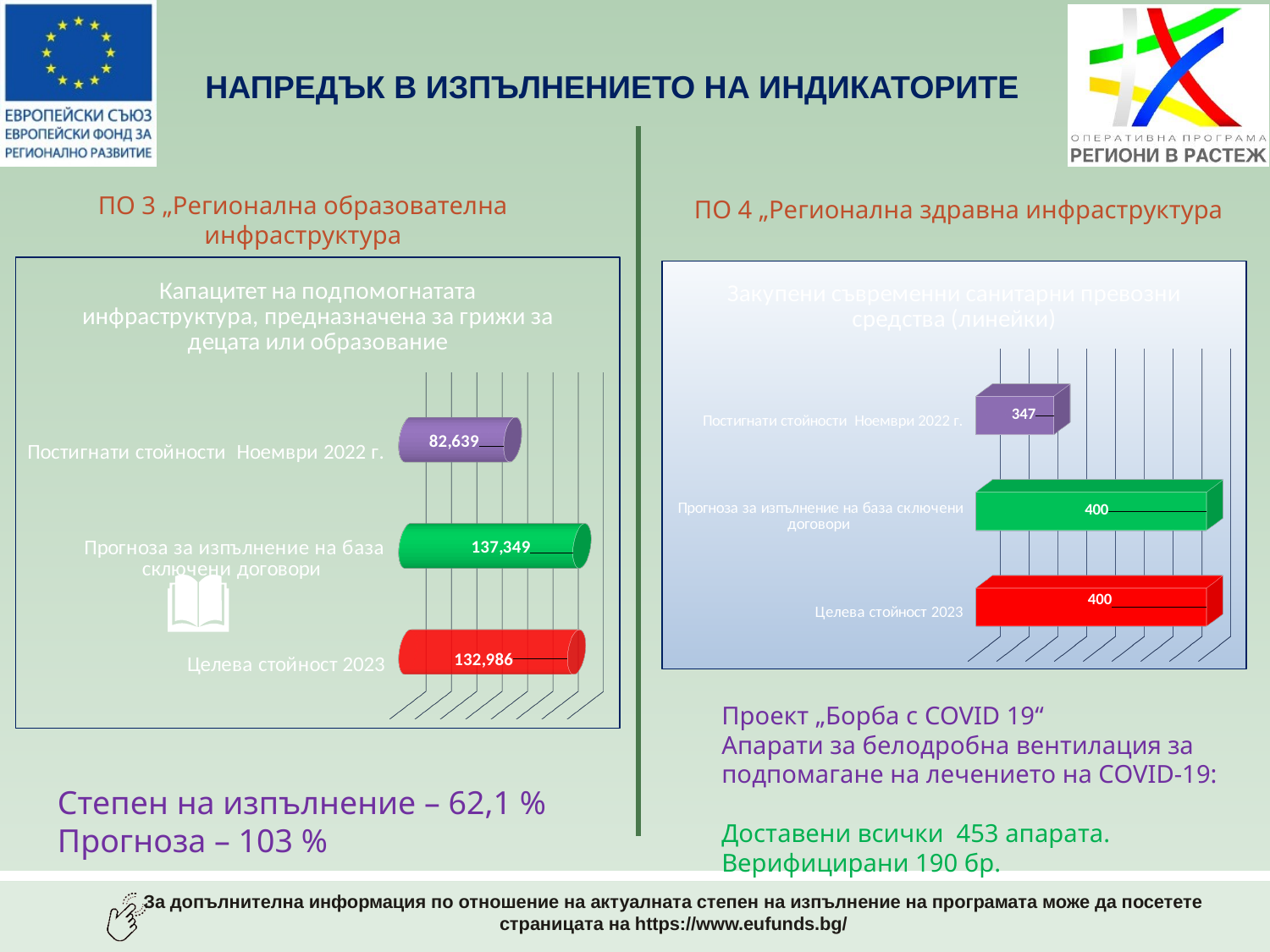
In the left chart (Капацитет на подпомогнатата инфраструктура), what is the difference between Прогноза за изпълнение на база сключени договори and Постигнати стойности Ноември 2022 г.? 54,710 In the left chart (Капацитет на подпомогнатата инфраструктура), what is the value for Целева стойност 2023? 132,986 In the right chart (Закупени съвременни санитарни превозни средства), what is the value for Постигнати стойности Ноември 2022 г.? 347 What type of chart is the right chart (Закупени съвременни санитарни превозни средства)? Bar chart In the left chart (Капацитет на подпомогнатата инфраструктура), which category has the lowest value? Постигнати стойности Ноември 2022 г. In the right chart (Закупени съвременни санитарни превозни средства), what is the difference between Целева стойност 2023 and Постигнати стойности Ноември 2022 г.? 53 In the right chart (Закупени съвременни санитарни превозни средства), which is larger: Прогноза за изпълнение на база сключени договори or Постигнати стойности Ноември 2022 г.? Прогноза за изпълнение на база сключени договори In the right chart (Закупени съвременни санитарни превозни средства), what is the value for Целева стойност 2023? 400 In the left chart (Капацитет на подпомогнатата инфраструктура), how many bars are plotted? 3 In the left chart (Капацитет на подпомогнатата инфраструктура), which category has the highest value? Прогноза за изпълнение на база сключени договори In the left chart (Капацитет на подпомогнатата инфраструктура), what is the value for Прогноза за изпълнение на база сключени договори? 137,349 In the left chart (Капацитет на подпомогнатата инфраструктура), what is the value for Постигнати стойности Ноември 2022 г.? 82,639